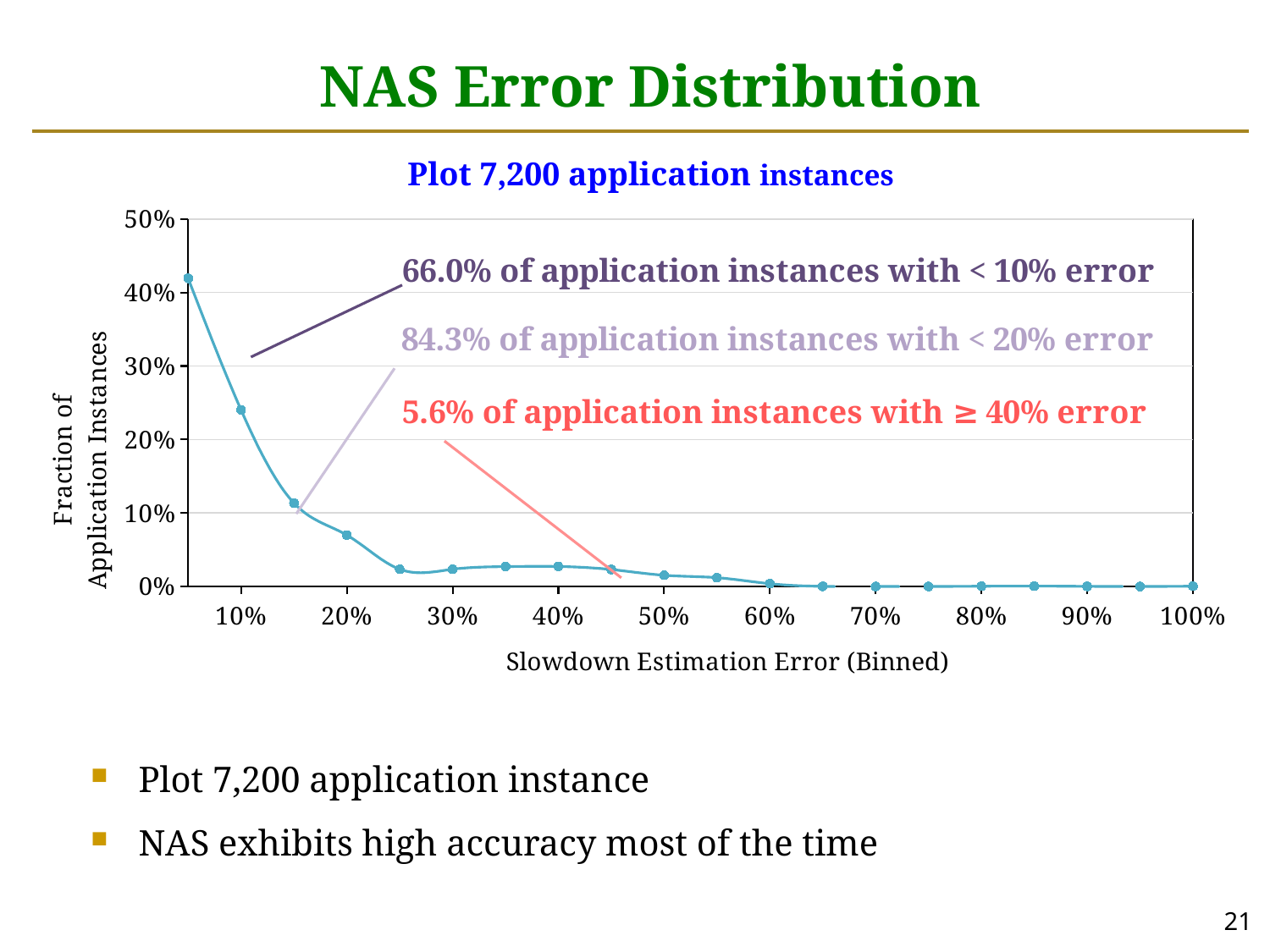
Is the value for the 10% error bin greater or less than 20%? greater How many labeled tick marks are on the x axis? 10 What is the highest value shown on the y axis? 50% According to the annotation on the chart, what percentage of application instances have < 20% error? 84.3% Which has a larger fraction of application instances, the 20% error bin or the 30% error bin? 20% What is the title of the x axis? Slowdown Estimation Error (Binned) Is the value for the 10% error bin greater or less than 30%? less Is the value for the 30% error bin greater or less than 10%? less Which has a larger fraction of application instances, the 10% error bin or the 20% error bin? 10% Do the values rise or fall as the slowdown estimation error increases along the x axis? fall What kind of chart is shown on the slide? line chart